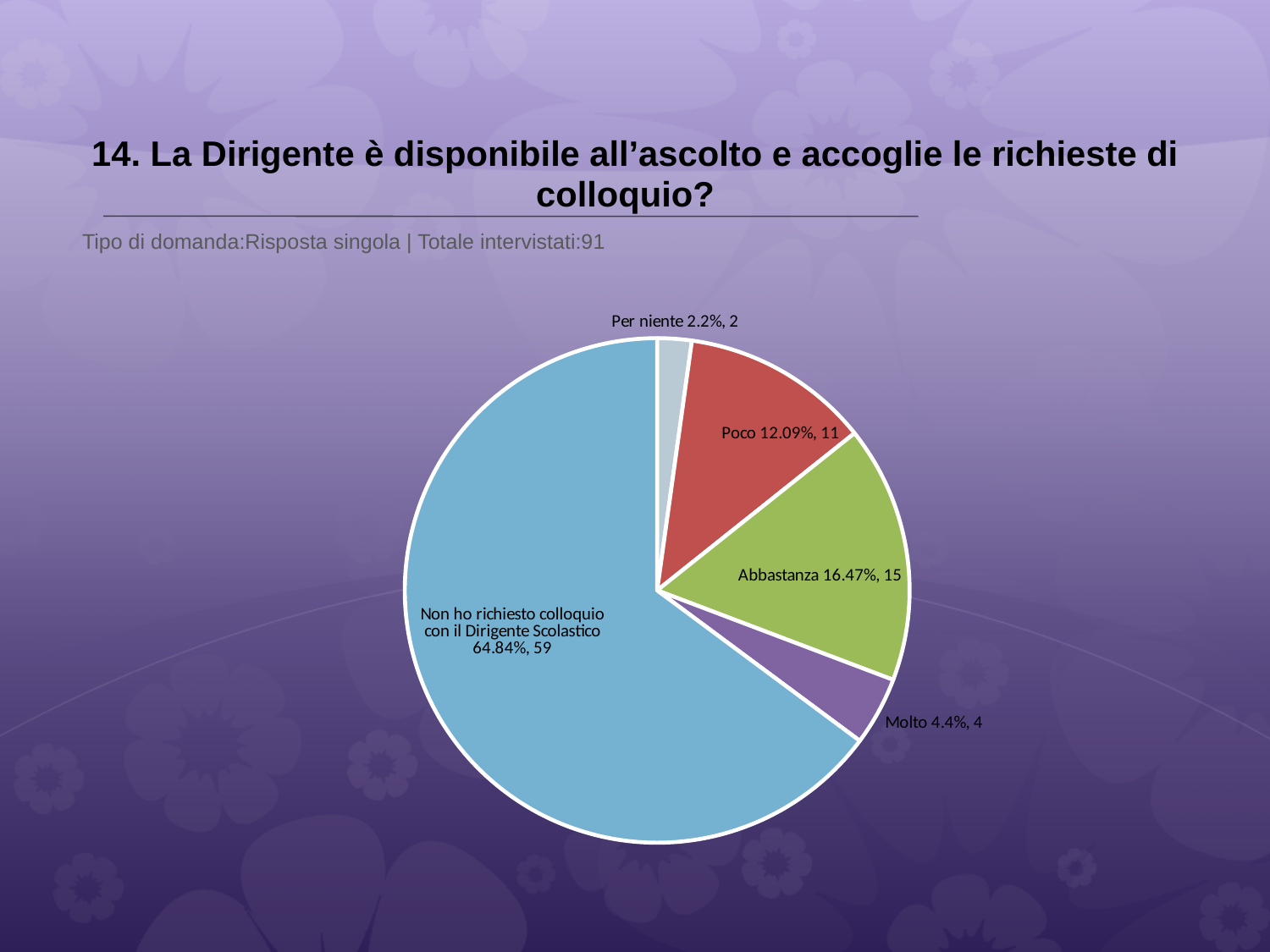
What kind of chart is shown on the slide? pie chart What percentage share does the 'Per niente' slice have? 2.2% What percentage share does the 'Non ho richiesto colloquio con il Dirigente Scolastico' slice have? 64.84% Which has more respondents, 'Poco' or 'Molto'? Poco What is the difference in respondent count between 'Abbastanza' and 'Poco'? 4 Which category has the smallest slice? Per niente What percentage share does the 'Poco' slice have? 12.09% How many respondents answered 'Molto'? 4 How many slices does the pie chart have? 5 How many respondents answered 'Abbastanza'? 15 Which category has the largest slice? Non ho richiesto colloquio con il Dirigente Scolastico What is the total number of respondents stated on the slide? 91